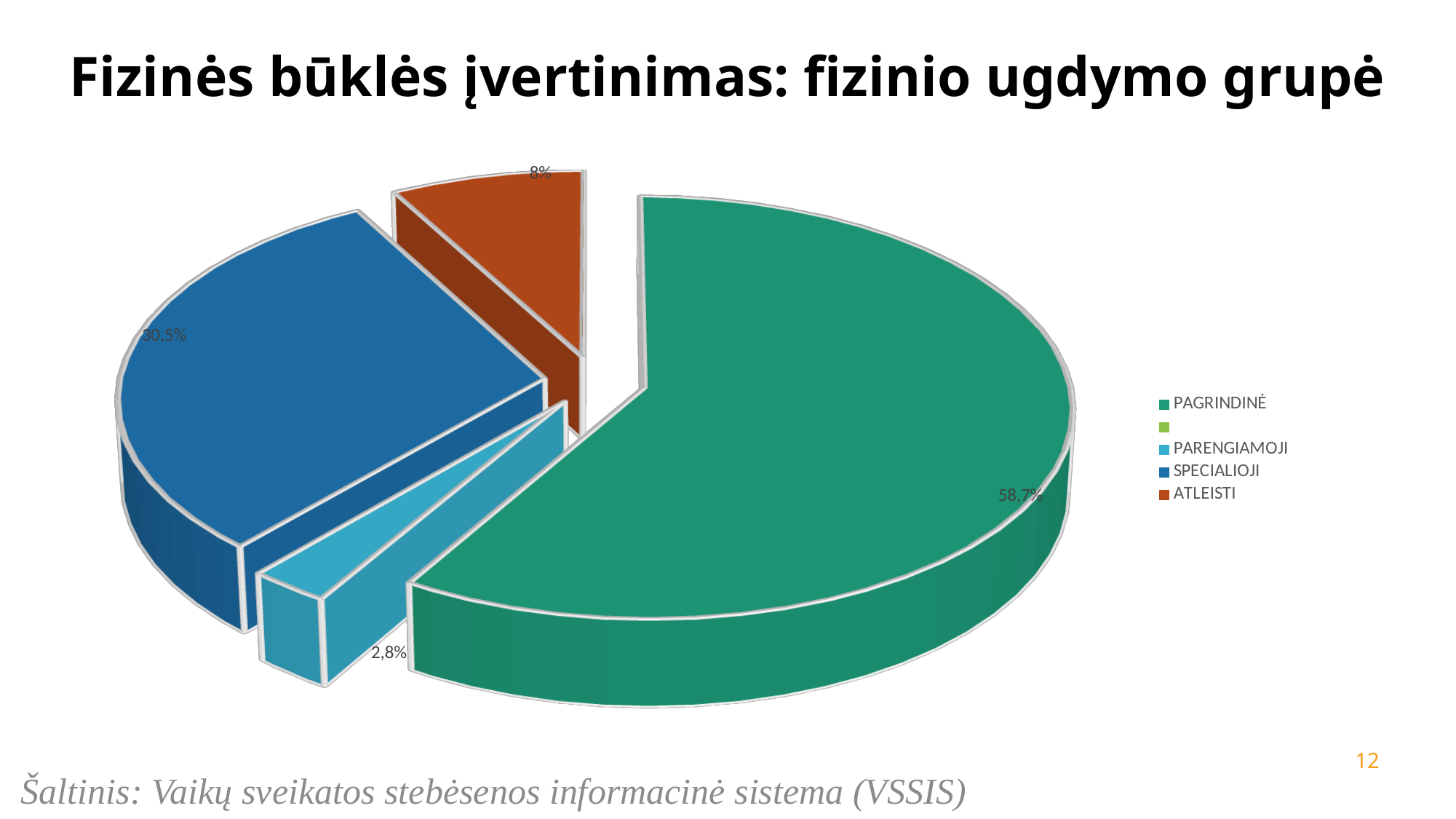
Which is larger, the slice for SPECIALIOJI or the slice for ATLEISTI? SPECIALIOJI What is the title of the slide containing the pie chart? Fizinės būklės įvertinimas: fizinio ugdymo grupė What is the difference in percentage points between PAGRINDINĖ and SPECIALIOJI? 28,2 What is the difference in percentage points between ATLEISTI and PARENGIAMOJI? 5,2 What share of the pie does SPECIALIOJI have? 30,5% What share of the pie does PARENGIAMOJI have? 2,8% What kind of chart is shown on the slide? pie chart How many slices with data labels does the pie chart have? 4 What share of the pie does ATLEISTI have? 8% What share of the pie does PAGRINDINĖ have? 58,7% Which category has the largest slice of the pie? PAGRINDINĖ Which category has the smallest slice of the pie? PARENGIAMOJI